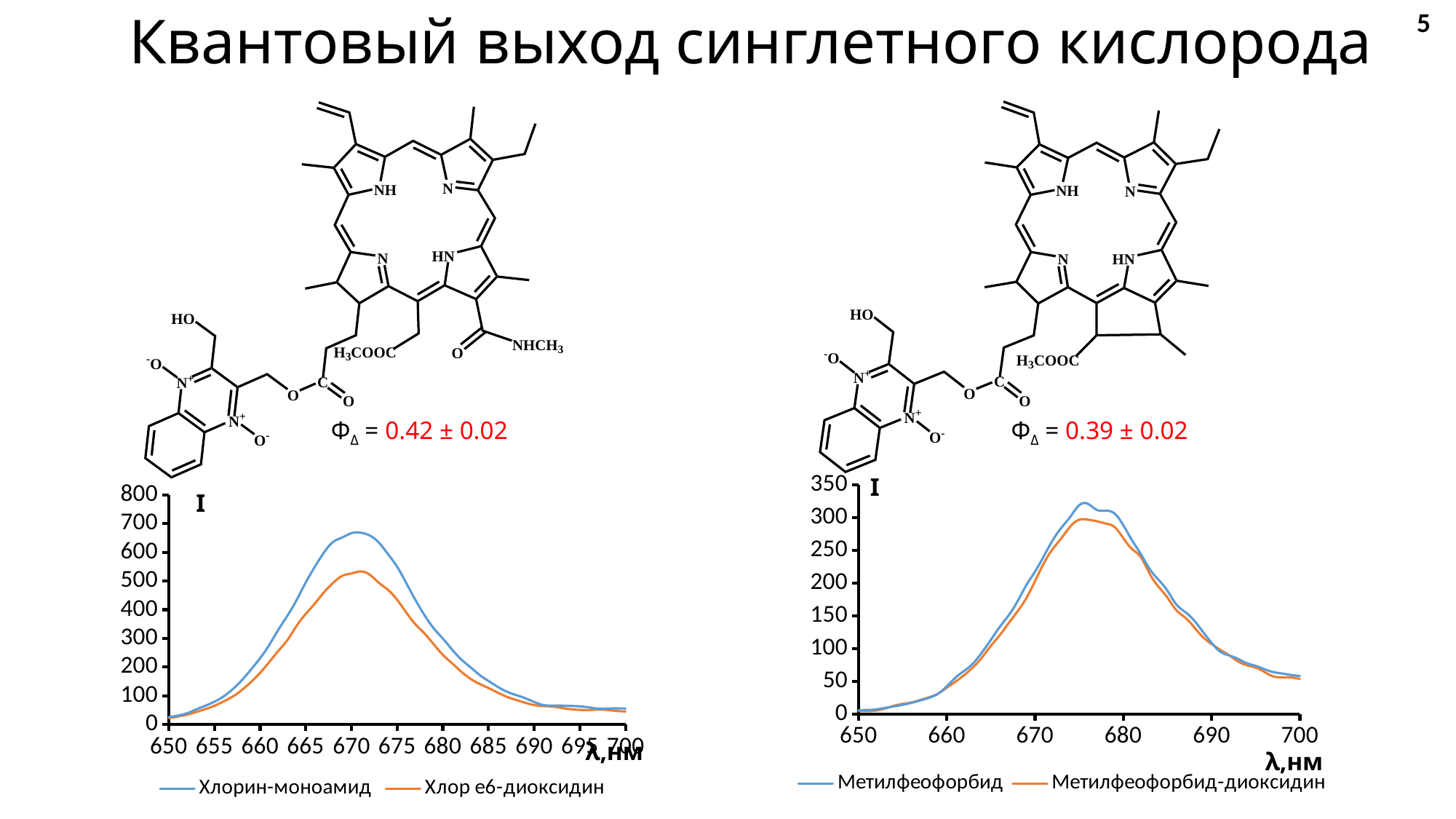
In the right chart, which series reaches the higher peak intensity? Метилфеофорбид In the left chart, is the peak value of Хлорин-моноамид greater or less than 600? greater In the right chart, do the values rise or fall as the wavelength goes from 650 nm to 670 nm? rise In the left chart, is the peak value of Хлор е6-диоксидин greater or less than 600? less In the right chart, is the peak value of Метилфеофорбид-диоксидин greater or less than 250? greater How many tick labels are shown on the x axis of the left chart? 11 How many series does the legend of the right chart list? 2 What kind of chart is the left chart on the slide? line chart In the left chart, which series reaches the higher peak intensity? Хлорин-моноамид What is the highest value labelled on the y axis of the right chart? 350 In the left chart, do the values rise or fall as the wavelength goes from 675 nm to 700 nm? fall